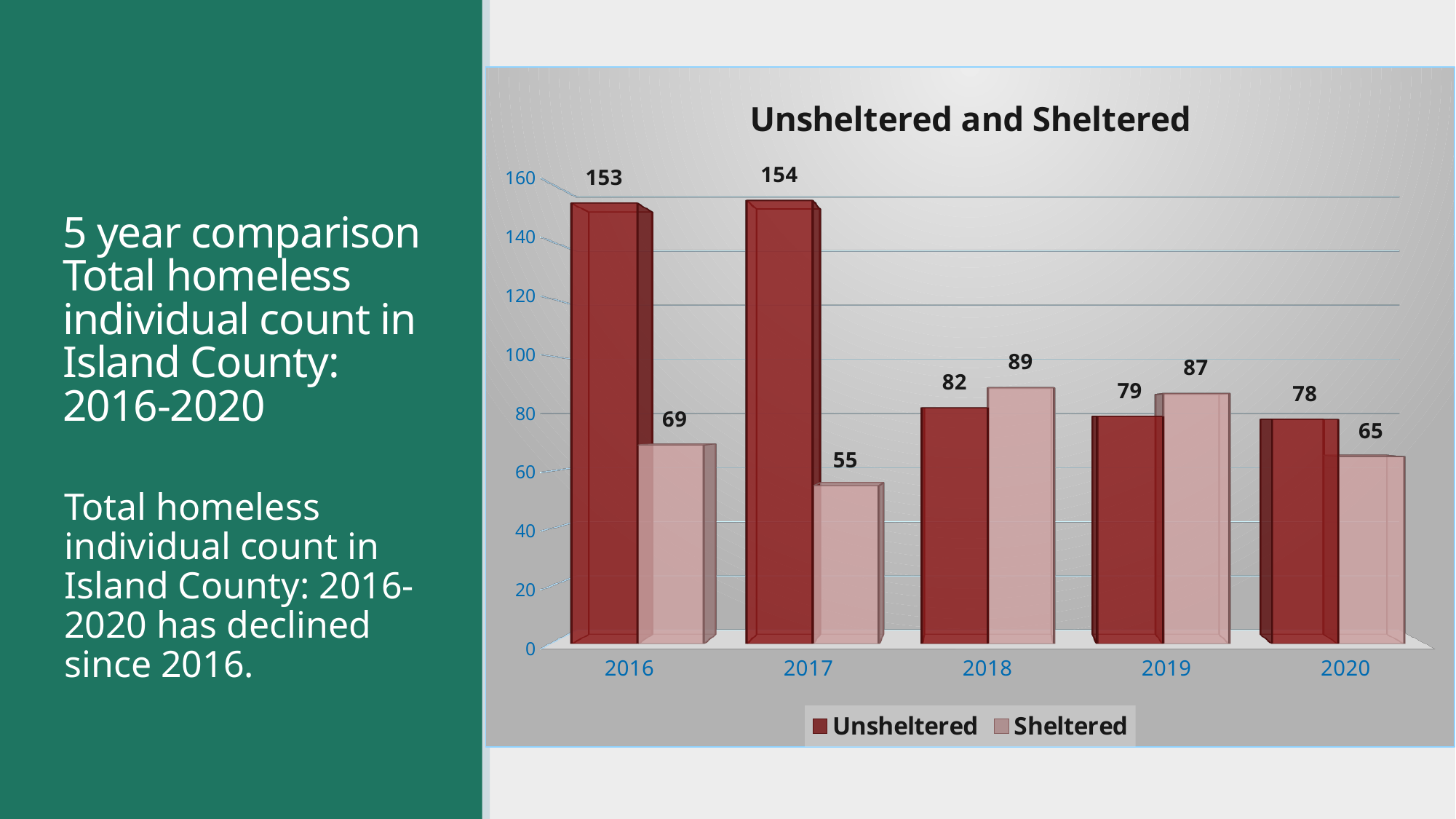
Which year has the highest Unsheltered value? 2017 How many series does the legend list? 2 What is the Sheltered value for 2020? 65 How many years are shown on the x axis? 5 What is the title of the chart? Unsheltered and Sheltered What is the Sheltered value for 2017? 55 In 2018, which is larger, the Unsheltered or the Sheltered value? Sheltered What kind of chart is shown? bar chart Which year has the lowest Sheltered value? 2017 What is the Unsheltered value for 2016? 153 Is the Unsheltered value for 2020 greater or less than 100? less What is the difference between the Unsheltered and Sheltered values in 2016? 84